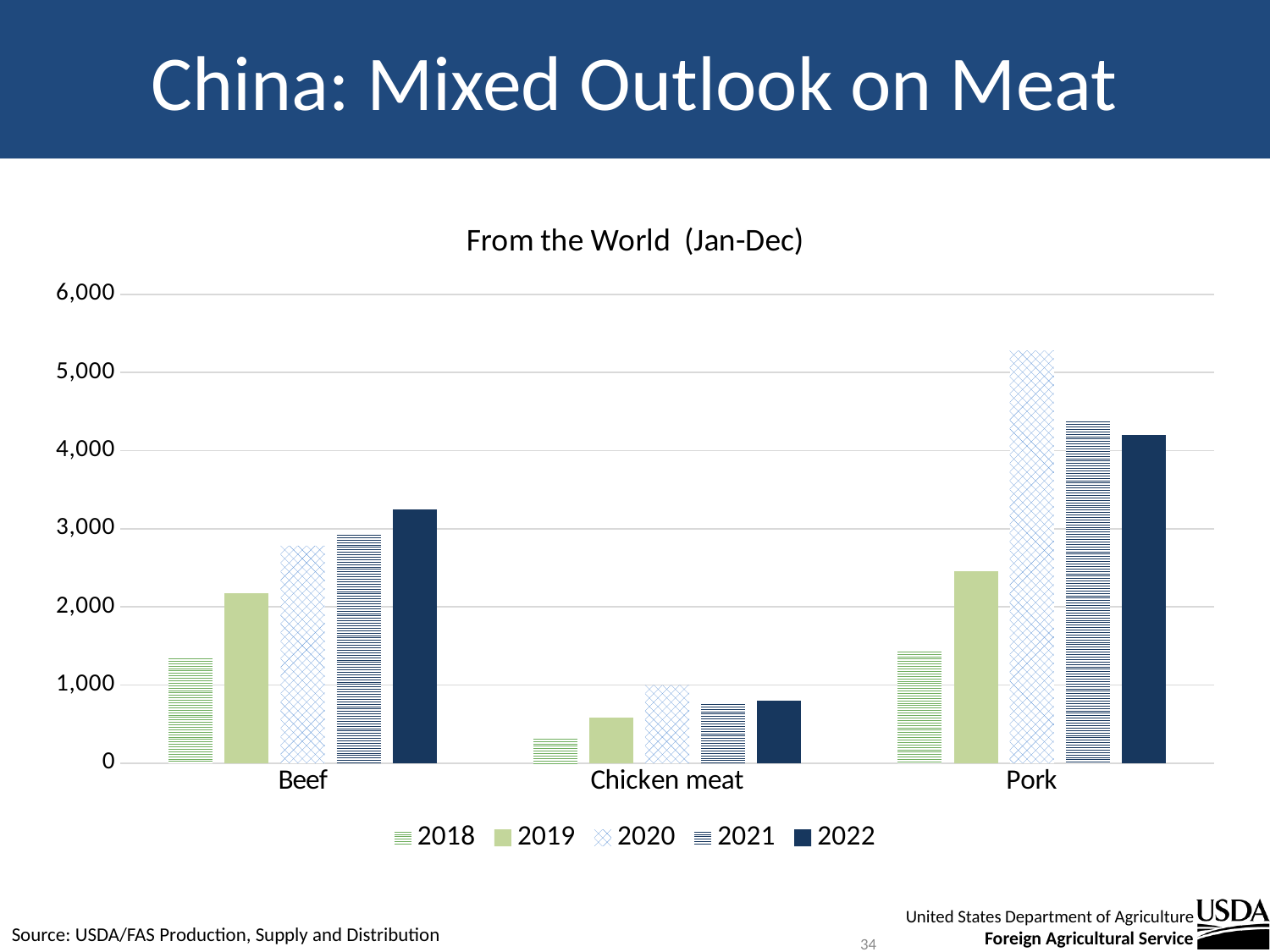
Is the 2020 value for Pork greater or less than 5,000? greater Do the Beef values rise or fall from 2018 to 2022? rise What is the title of the chart? From the World (Jan-Dec) Which category contains the tallest bar in the chart? Pork Which is larger, the 2022 value for Beef or the 2022 value for Pork? Pork Is the 2022 value for Beef greater or less than 3,000? greater How many series does the legend list? 5 Is the 2018 value for Chicken meat greater or less than 1,000? less Which category has the lowest 2018 value? Chicken meat What kind of chart is shown on the slide? bar chart How many meat categories are shown on the x axis? 3 For Pork, which year has the highest bar? 2020